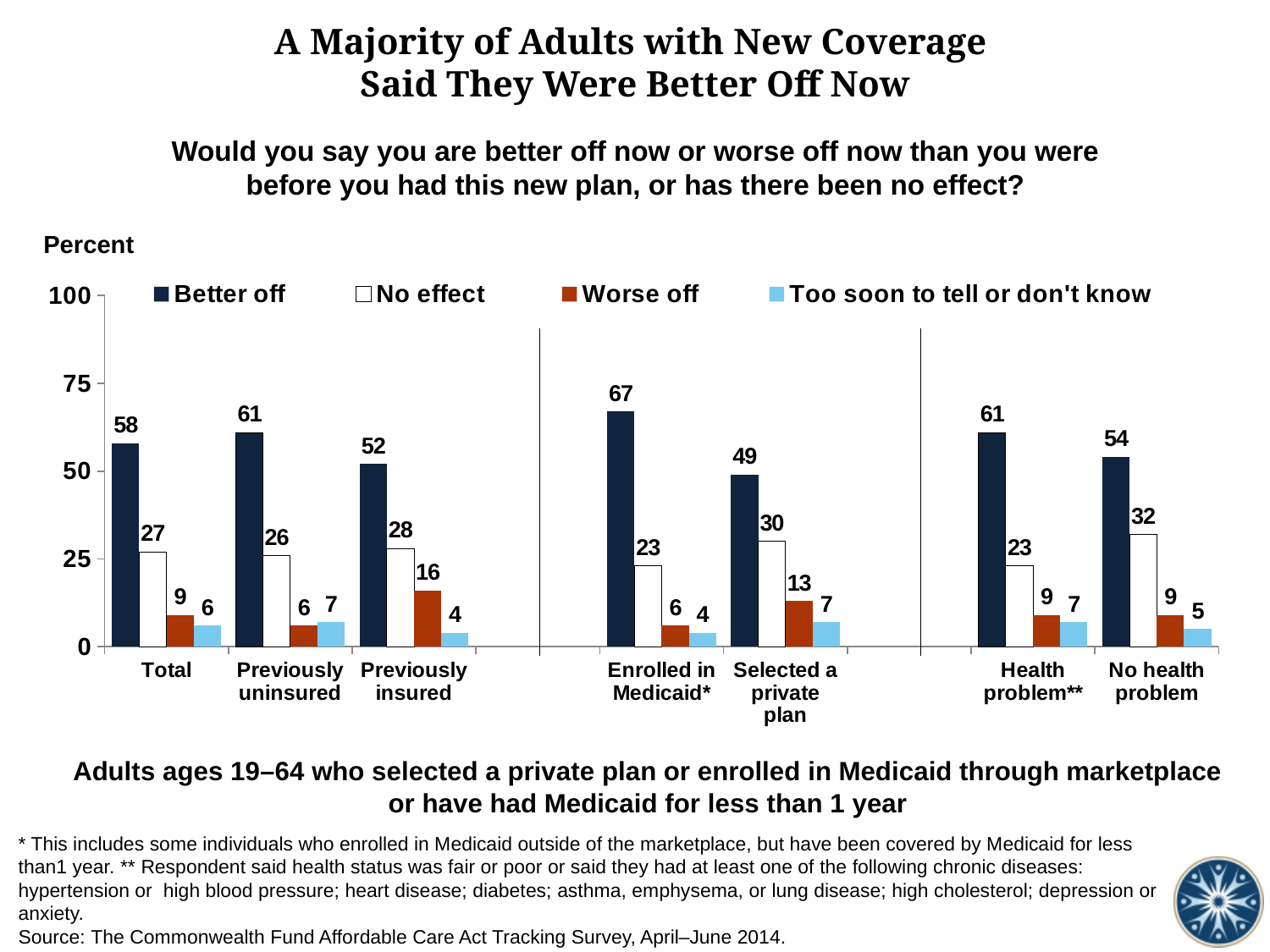
How many categories are shown on the x axis? 7 What is the 'No effect' value for the Previously insured group? 28 What is the 'Worse off' value for those who selected a private plan? 13 What kind of chart is shown on the slide? bar chart Is the 'Better off' value for Enrolled in Medicaid* greater or less than 50? greater How many series does the legend list? 4 Which category has the lowest 'Better off' value? Selected a private plan What is the difference between the 'Better off' values for Health problem** and No health problem? 7 Which is larger: the 'Worse off' value for Previously insured or for Previously uninsured? Previously insured What percentage of adults in the Total group said they were better off? 58 What is the 'Too soon to tell or don't know' value for the No health problem group? 5 Which category has the highest 'Better off' value? Enrolled in Medicaid*